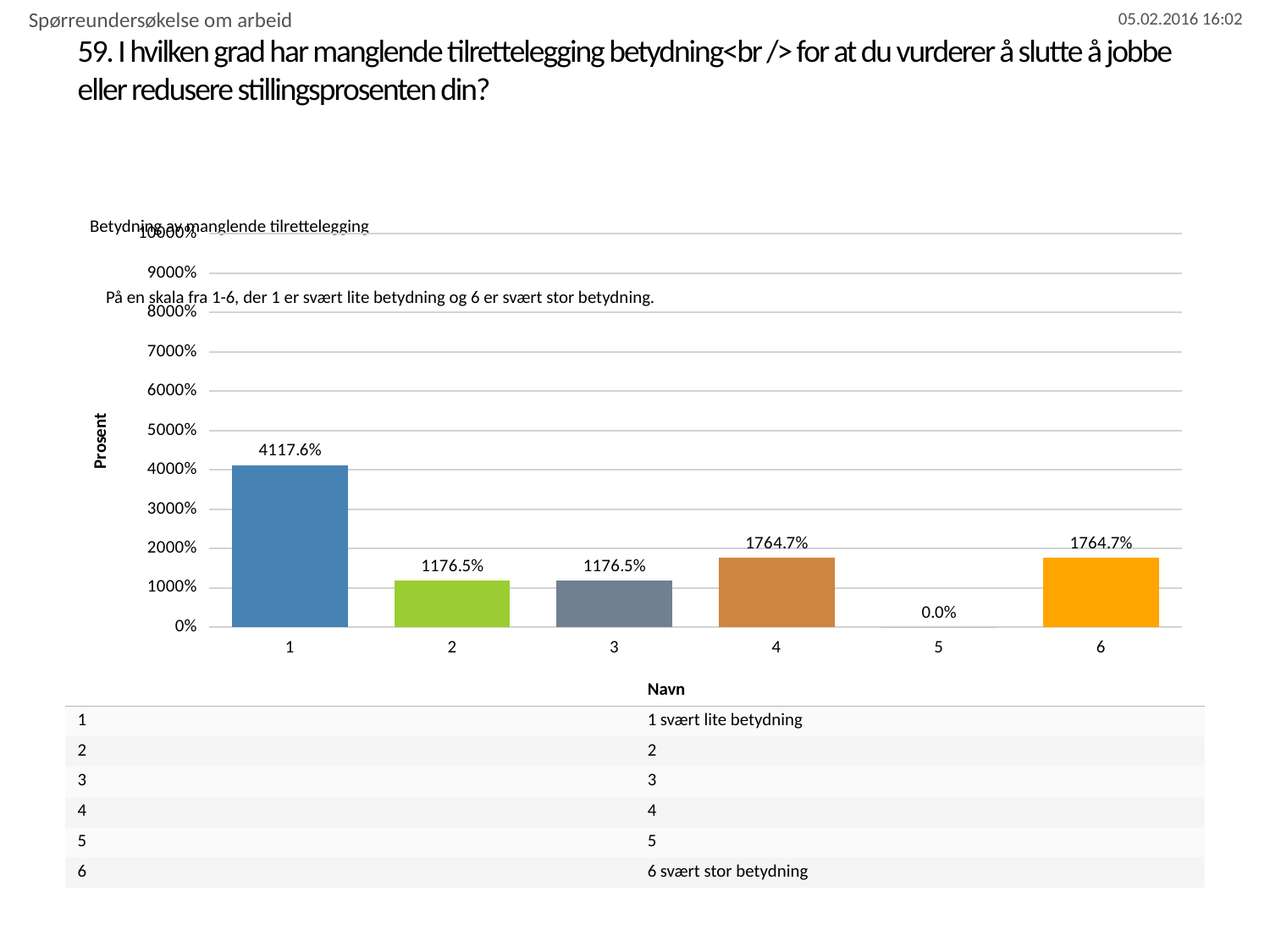
What is the difference between the values for category 1 and category 6? 2352.9% What is the value for category 5? 0.0% Is the value for category 1 greater or less than 3000%? greater What is the difference between the values for category 4 and category 2? 588.2% What is the value for category 1? 4117.6% Which is larger, the value for category 4 or the value for category 3? 4 What is the label of the y axis? Prosent What kind of chart is shown on the slide? bar chart Which category has the lowest value? 5 How many categories are shown on the x axis? 6 What is the value for category 4? 1764.7% Which category has the highest value? 1